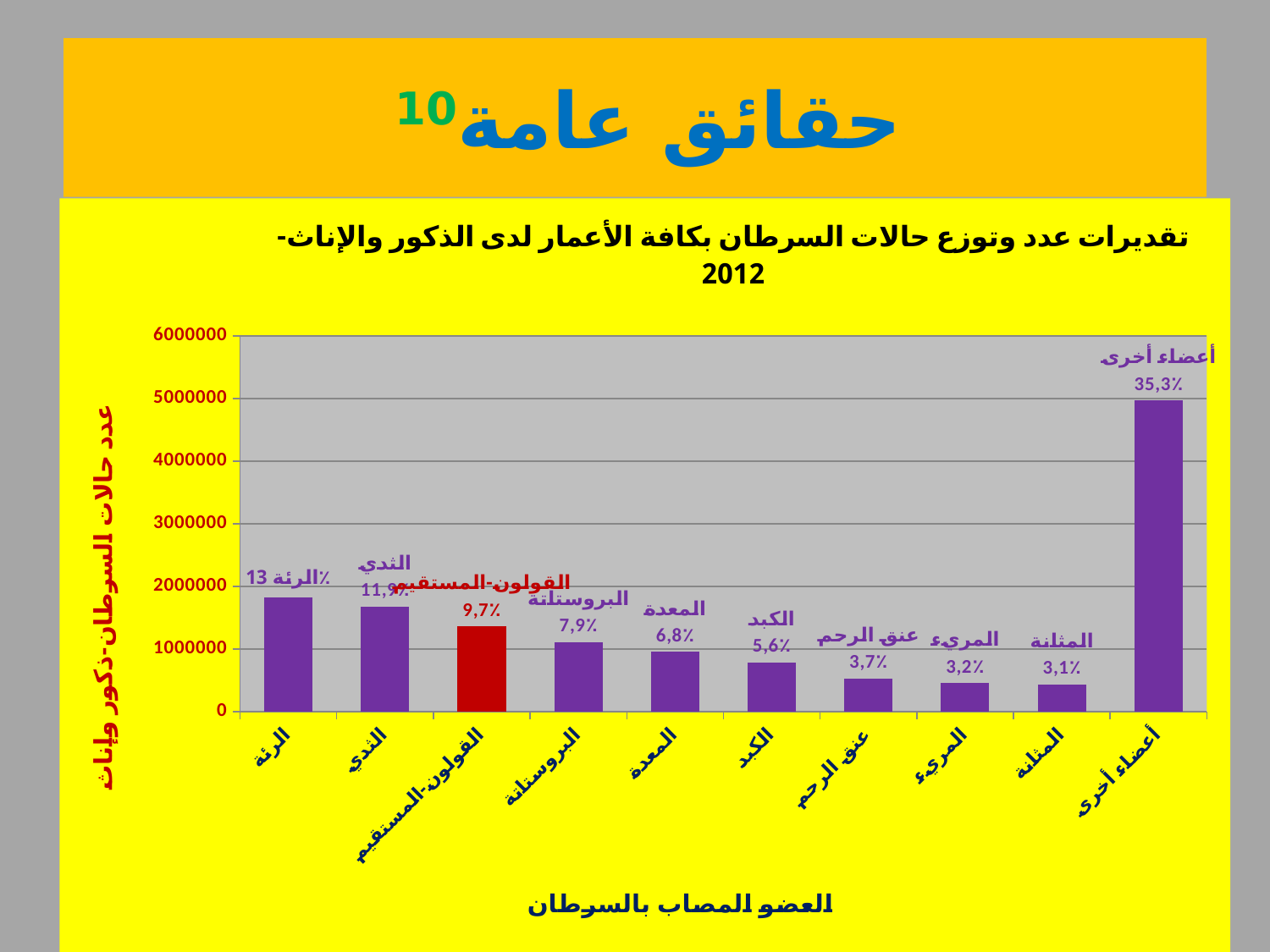
Which is larger, the value for المعدة or the value for الكبد? المعدة What is the difference in percentage points between أعضاء أخرى (35,3%) and الرئة (13%)? 22,3% What percentage is shown for أعضاء أخرى (other organs)? 35,3% How many categories are shown on the x axis? 10 Is the number of cases for أعضاء أخرى greater or less than 4000000? greater What kind of chart is this? bar chart What percentage is shown for الكبد (liver)? 5,6% Is the number of cases for الرئة greater or less than 2000000? less Which category has the highest value? أعضاء أخرى What colour is the bar for القولون-المستقيم? red What percentage is shown for البروستاتة (prostate)? 7,9% Which category has the lowest value? المثانة